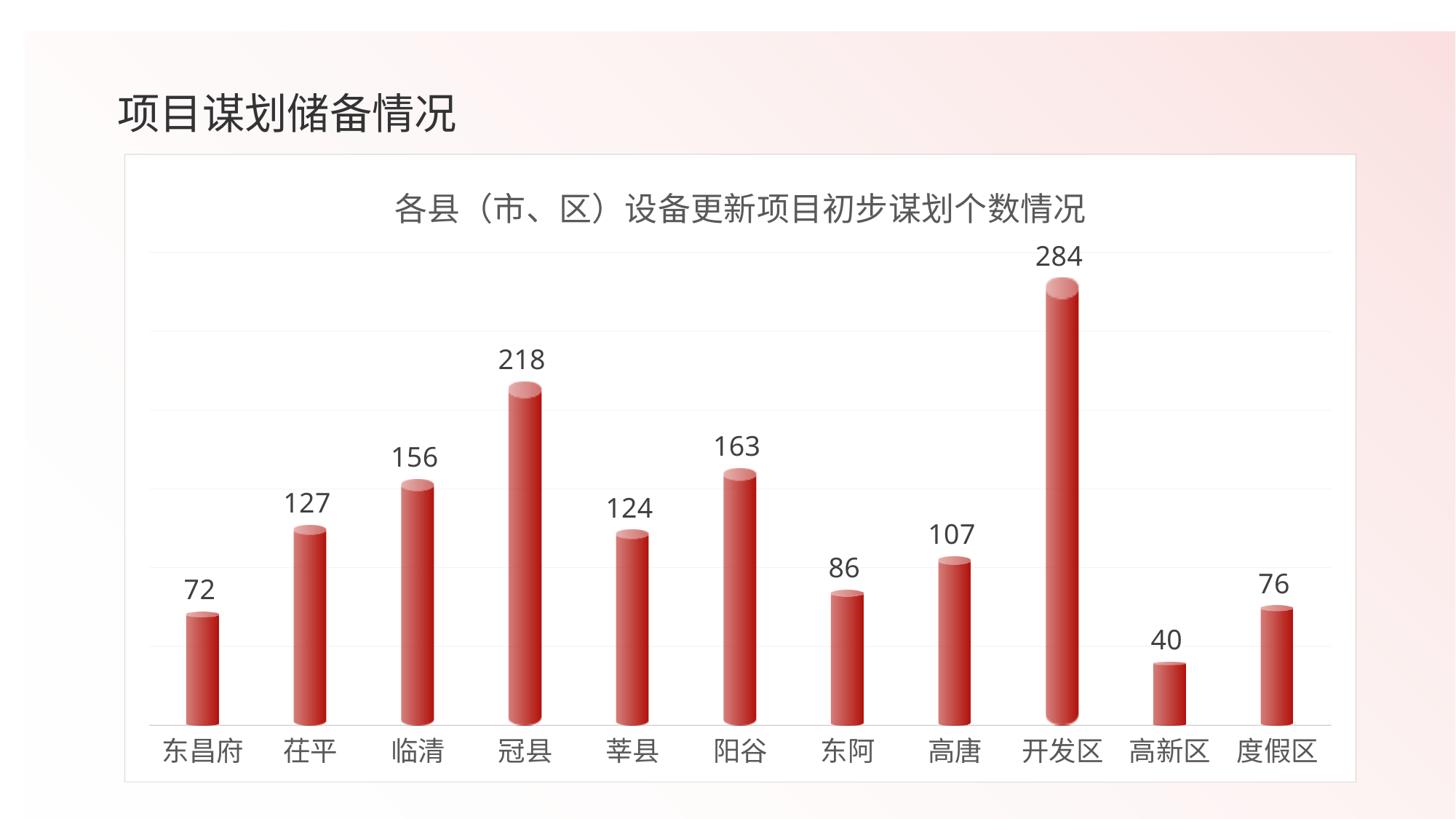
What kind of chart is shown on the slide? bar chart Which category has the lowest value? 高新区 What is the difference between the values for 开发区 and 冠县? 66 How many categories are shown on the x axis? 11 What is the value for 冠县? 218 Which category has the highest value? 开发区 What is the value for 度假区? 76 What is the difference between the values for 临清 and 茌平? 29 What is the title of the chart? 各县（市、区）设备更新项目初步谋划个数情况 What is the value for 高唐? 107 Which is larger, the value for 阳谷 or the value for 莘县? 阳谷 Which is larger, the value for 东昌府 or the value for 东阿? 东阿